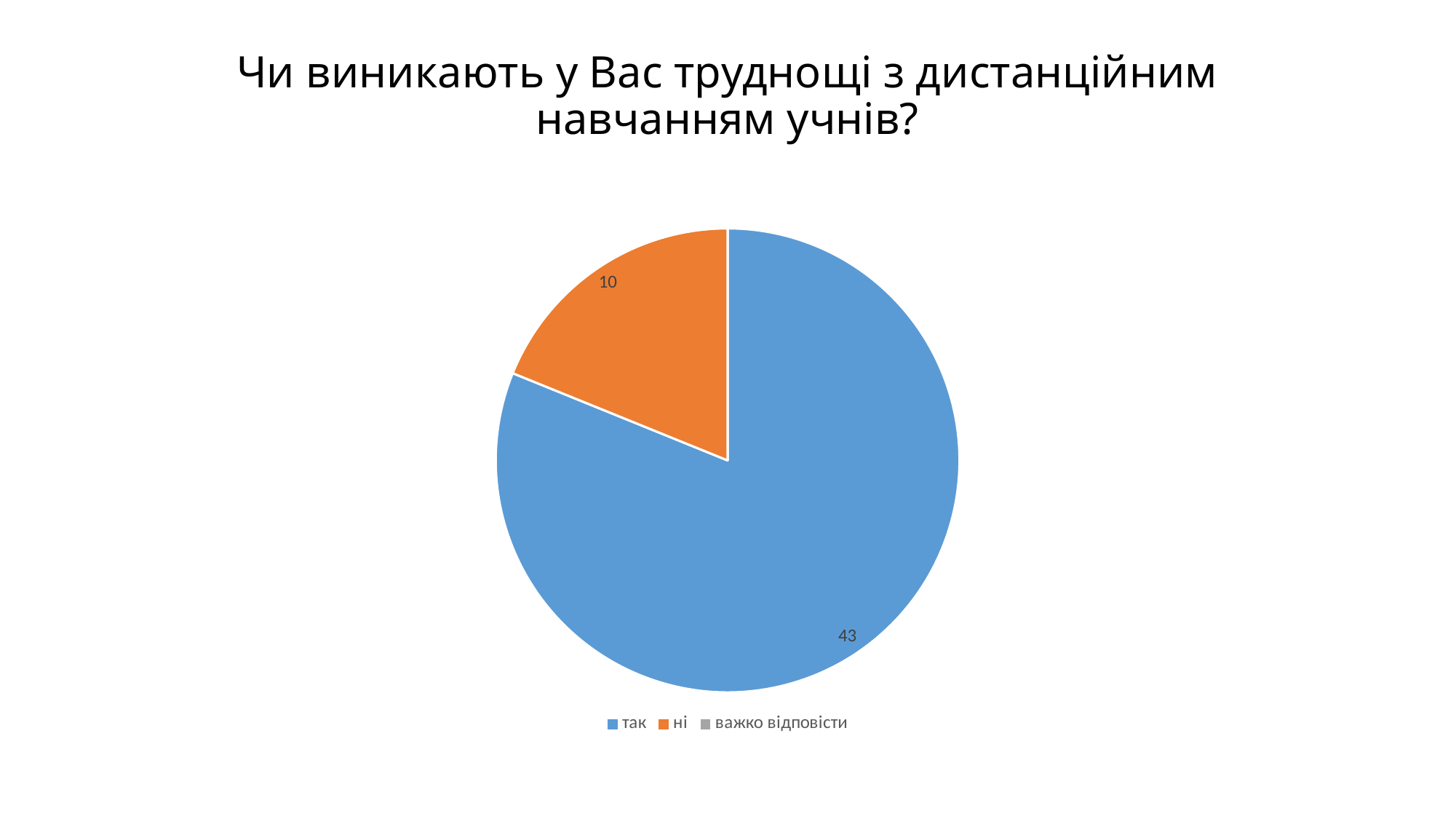
What value is shown for the "ні" slice of the pie chart? 10 What value is shown for the "так" slice of the pie chart? 43 What is the title of the chart on the slide? Чи виникають у Вас труднощі з дистанційним навчанням учнів? What is the difference between the values for "так" and "ні"? 33 Which category has the largest slice in the pie chart? так How many entries does the legend of the chart list? 3 What kind of chart is shown on the slide? pie chart What colour is the "так" slice in the pie chart? blue Which of the labelled slices is the smallest in the pie chart? ні Which is larger, the value for "так" or the value for "ні"? так